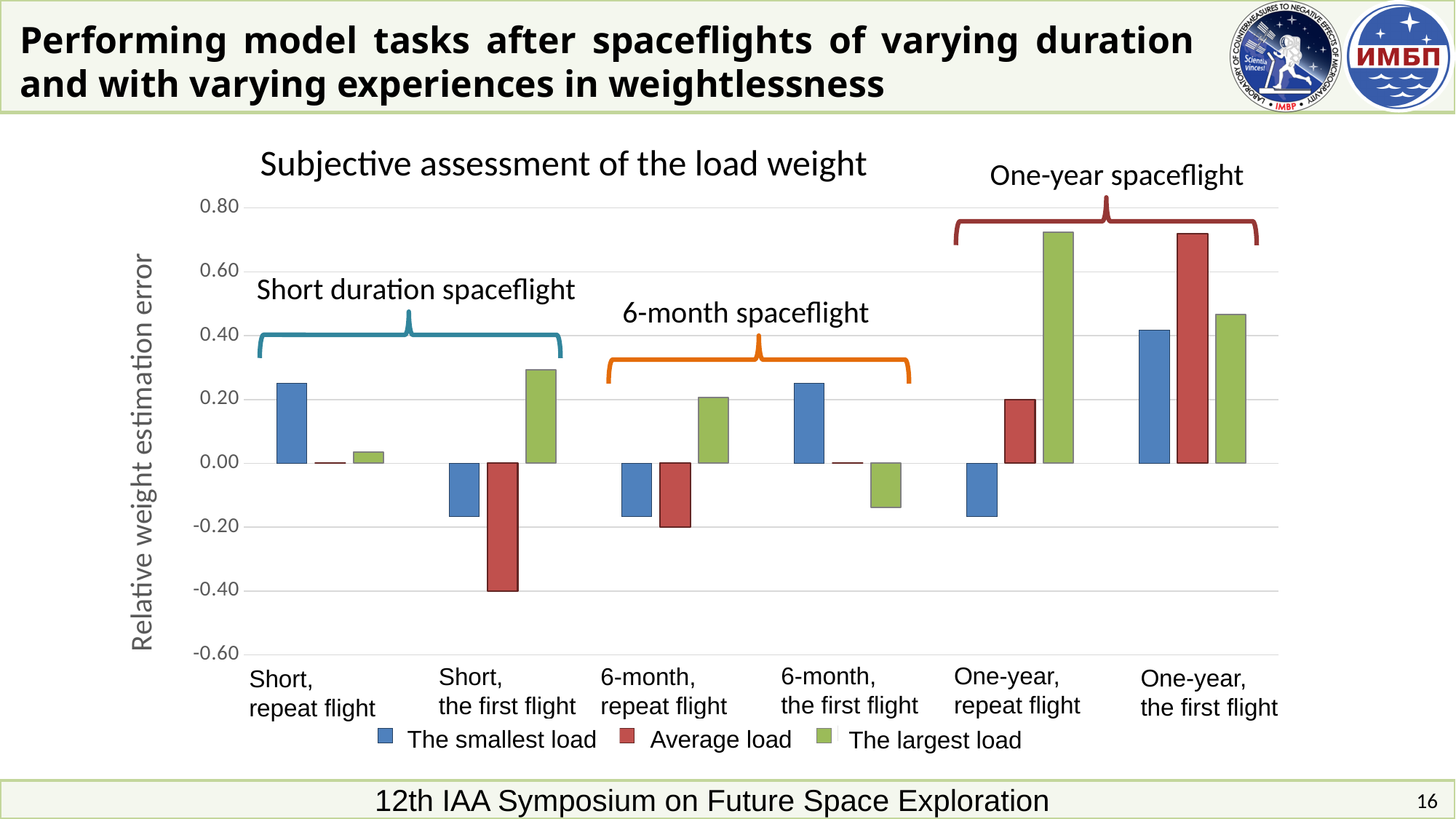
Which flight category has the lowest value for Average load? Short, the first flight What is the title of the chart? Subjective assessment of the load weight Is the Average load value for Short, the first flight greater or less than -0.20? less Which flight category has the highest value for Average load? One-year, the first flight How many series does the legend list? 3 Which is larger: The largest load value for 6-month, repeat flight or for 6-month, the first flight? 6-month, repeat flight How many flight categories are shown along the x axis? 6 Is the value of The largest load for One-year, repeat flight greater or less than 0.60? greater What kind of chart is shown on the slide? Bar chart Which flight category has the highest value for The largest load? One-year, repeat flight Which flight category has the highest value for The smallest load? One-year, the first flight Which is larger: The smallest load value for One-year, the first flight or for Short, repeat flight? One-year, the first flight